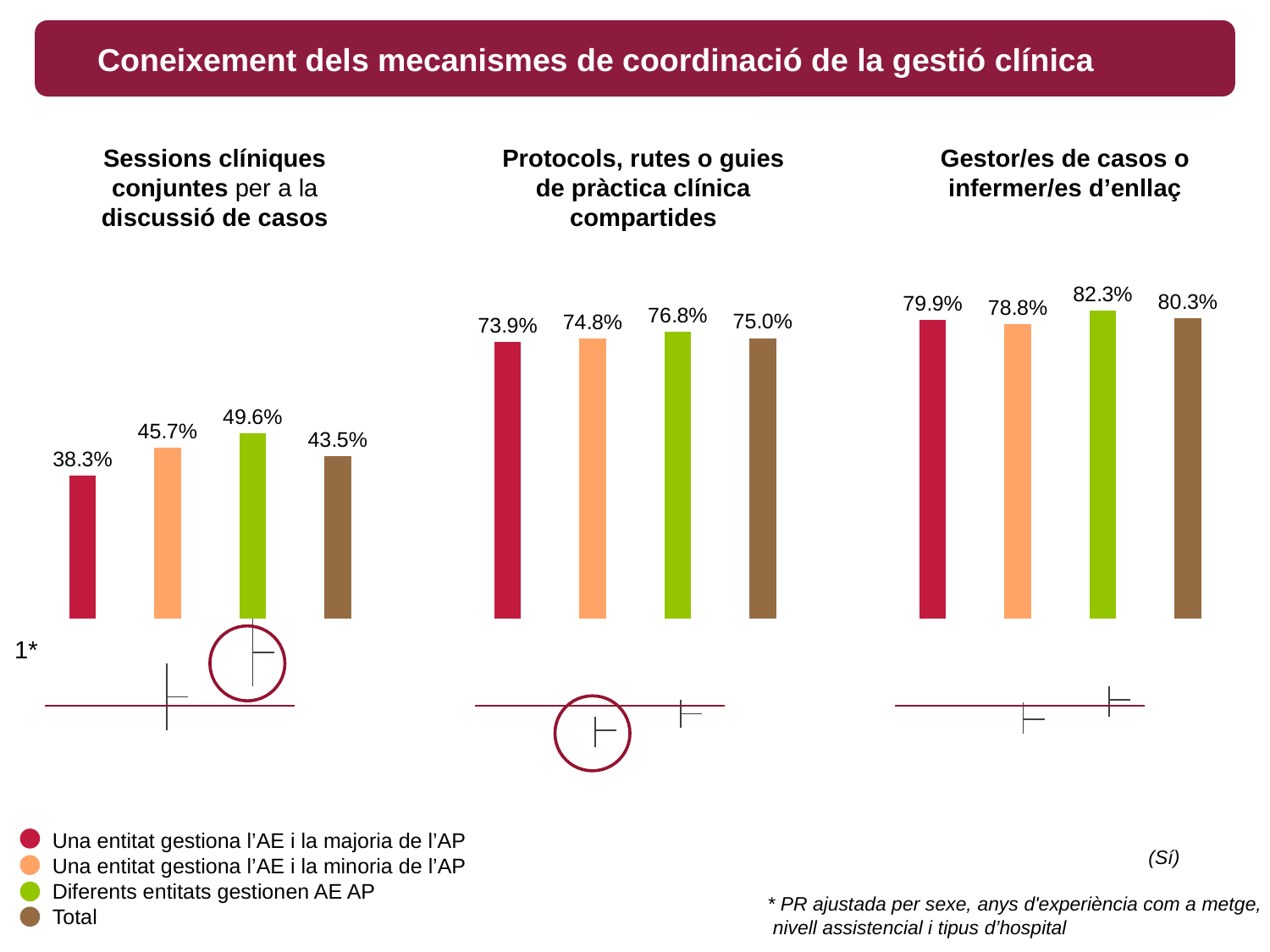
In the 'Protocols, rutes o guies de pràctica clínica compartides' chart, what is the difference between 'Total' and 'Una entitat gestiona l'AE i la majoria de l'AP'? 1.1% How many bars are shown in the 'Protocols, rutes o guies de pràctica clínica compartides' chart? 4 In the 'Gestor/es de casos o infermer/es d'enllaç' chart, which is larger: 'Diferents entitats gestionen AE AP' or 'Total'? Diferents entitats gestionen AE AP In the 'Sessions clíniques conjuntes per a la discussió de casos' chart, which category has the highest value? Diferents entitats gestionen AE AP In the 'Sessions clíniques conjuntes per a la discussió de casos' chart, what is the difference between 'Diferents entitats gestionen AE AP' and 'Una entitat gestiona l'AE i la majoria de l'AP'? 11.3% In the 'Protocols, rutes o guies de pràctica clínica compartides' chart, what is the value for 'Diferents entitats gestionen AE AP'? 76.8% In the 'Gestor/es de casos o infermer/es d'enllaç' chart, which category has the lowest value? Una entitat gestiona l'AE i la minoria de l'AP In the 'Gestor/es de casos o infermer/es d'enllaç' chart, what is the value for 'Una entitat gestiona l'AE i la minoria de l'AP'? 78.8% How many series does the legend list? 4 In the 'Sessions clíniques conjuntes per a la discussió de casos' chart, what is the value for 'Total'? 43.5% In the 'Sessions clíniques conjuntes per a la discussió de casos' chart, what is the value for 'Una entitat gestiona l'AE i la majoria de l'AP'? 38.3% What kind of chart is the 'Gestor/es de casos o infermer/es d'enllaç' chart? Bar chart